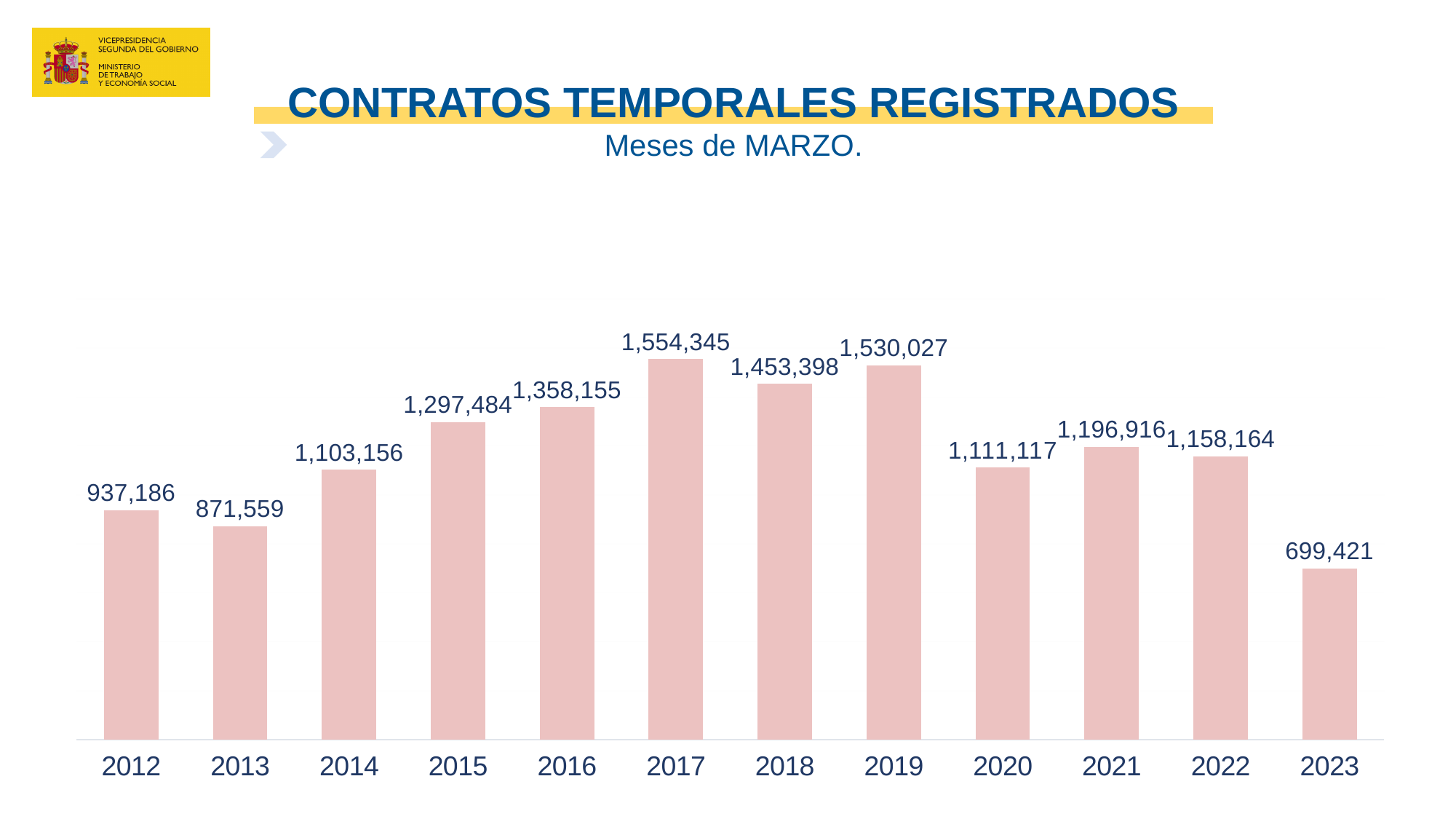
Which is larger, the value for 2012 or the value for 2013? 2012 How many years are shown on the x axis? 12 What kind of chart is shown on the slide? Bar chart Do the values rise or fall from 2013 to 2017? Rise What is the value for 2020? 1,111,117 What is the difference between the values for 2022 and 2023? 458,743 Which year has the lowest value? 2023 What is the value for 2017? 1,554,345 Which year has the highest value? 2017 What is the difference between the values for 2017 and 2023? 854,924 Which is larger, the value for 2019 or the value for 2018? 2019 What is the value for 2023? 699,421